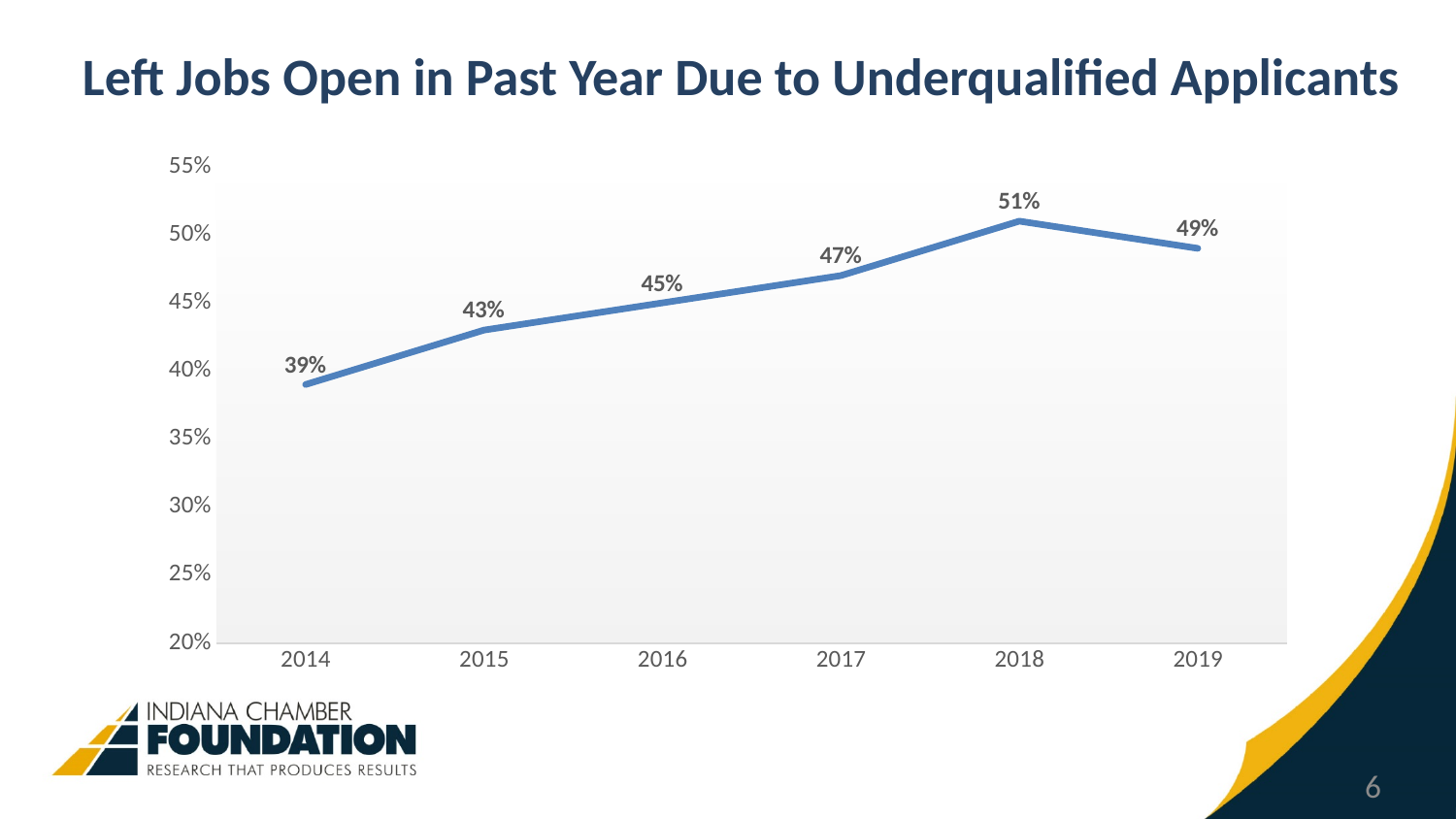
What is the difference between the values for 2018 and 2014? 12% How many years are plotted on the chart? 6 Is the value for 2015 greater or less than 40%? greater What is the title of the chart? Left Jobs Open in Past Year Due to Underqualified Applicants What is the value for 2019? 49% Which year has the lowest value? 2014 What is the difference between the values for 2019 and 2018? 2% What is the value for 2018? 51% Which year has the highest value? 2018 What is the value for 2014? 39% What kind of chart is shown on the slide? line chart Which is larger, the value for 2016 or the value for 2017? 2017